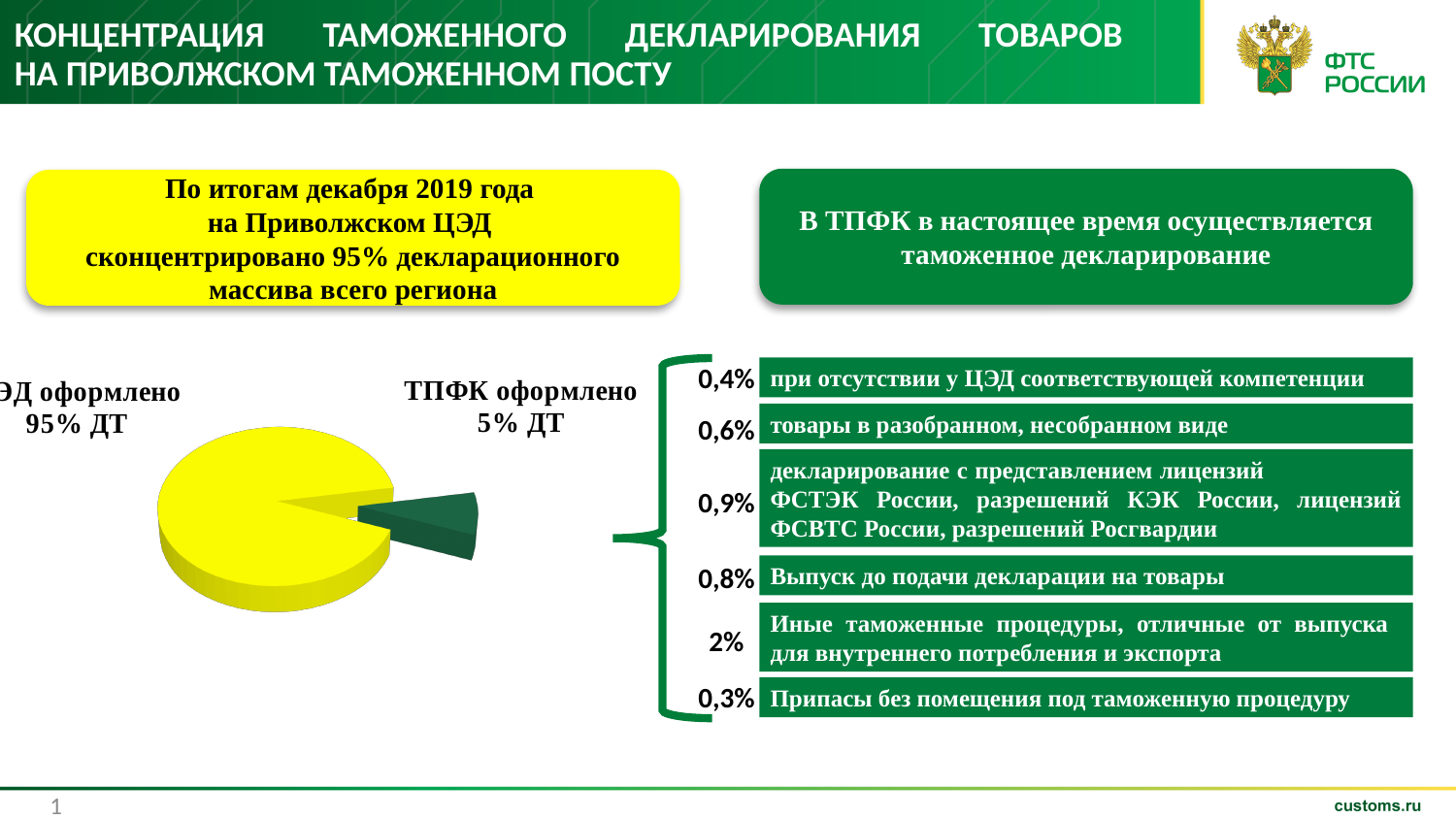
Is the ТПФК share in the pie chart greater or less than 50%? less What do the two pie chart shares add up to? 100% What share of the pie chart is labelled as processed by ЦЭД? 95% ДТ What colour is the ЦЭД slice in the pie chart? yellow How many slices does the pie chart have? 2 What colour is the ТПФК slice in the pie chart? green What share of the pie chart is labelled as processed by ТПФК? 5% ДТ What kind of chart is shown on the slide? pie chart Which slice of the pie chart is the largest? ЦЭД оформлено Which is larger in the pie chart: the ЦЭД share or the ТПФК share? ЦЭД What is the difference in percentage points between the ЦЭД share and the ТПФК share in the pie chart? 90 Which slice of the pie chart is the smallest? ТПФК оформлено